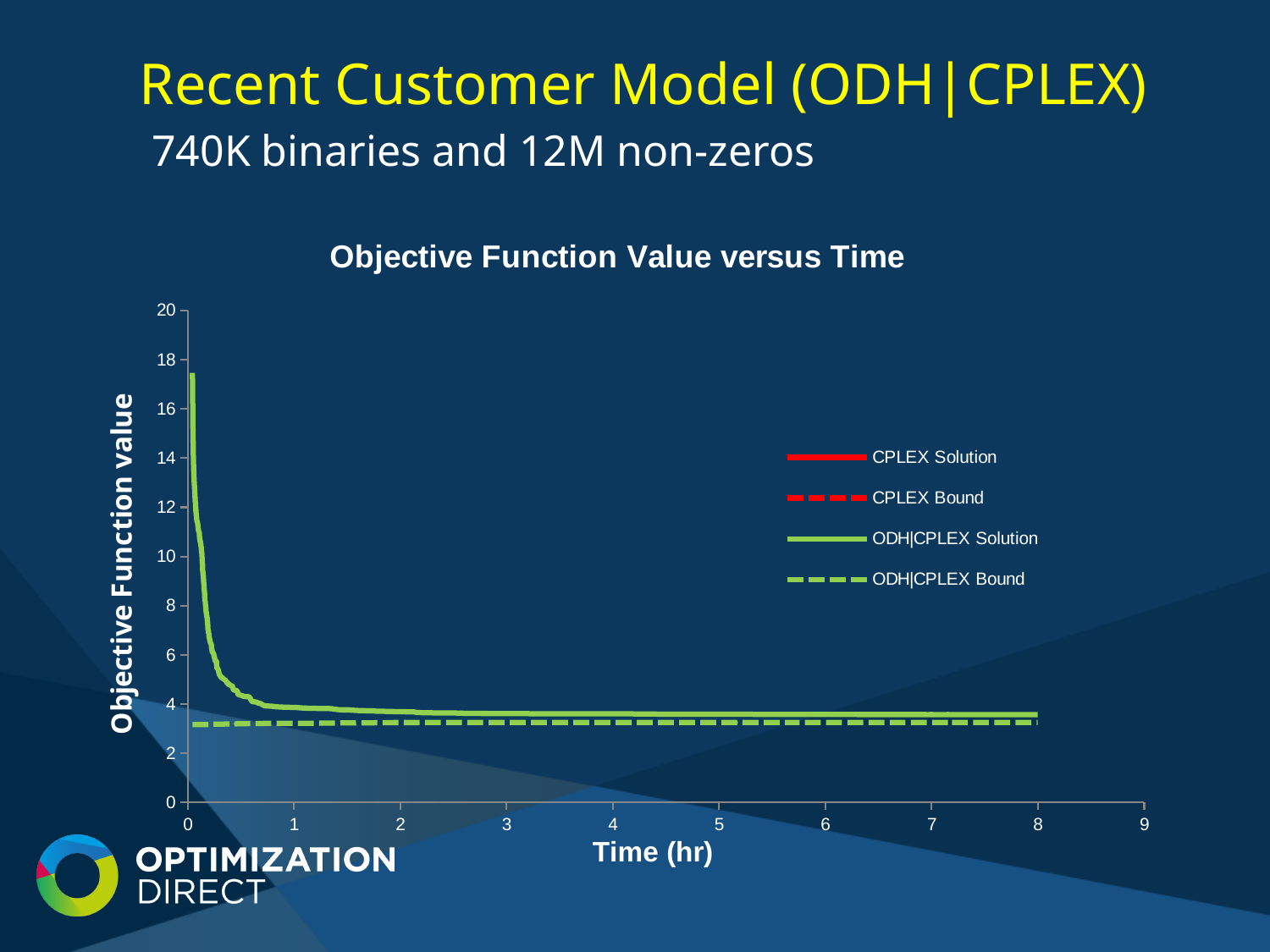
What is the highest value shown on the y axis? 20 Is the ODH|CPLEX Solution value at time 8 hr greater or less than 6? less Is the ODH|CPLEX Solution value at time 1 hr greater or less than 6? less Does the ODH|CPLEX Solution line rise or fall as time increases? fall Is the ODH|CPLEX Solution value at time 0 greater or less than 16? greater What is the title of the chart? Objective Function Value versus Time How many series does the chart legend list? 4 What kind of chart is shown on the slide? line chart At time 8 hr, which is larger: the ODH|CPLEX Solution or the ODH|CPLEX Bound? ODH|CPLEX Solution What is the label of the x axis? Time (hr)